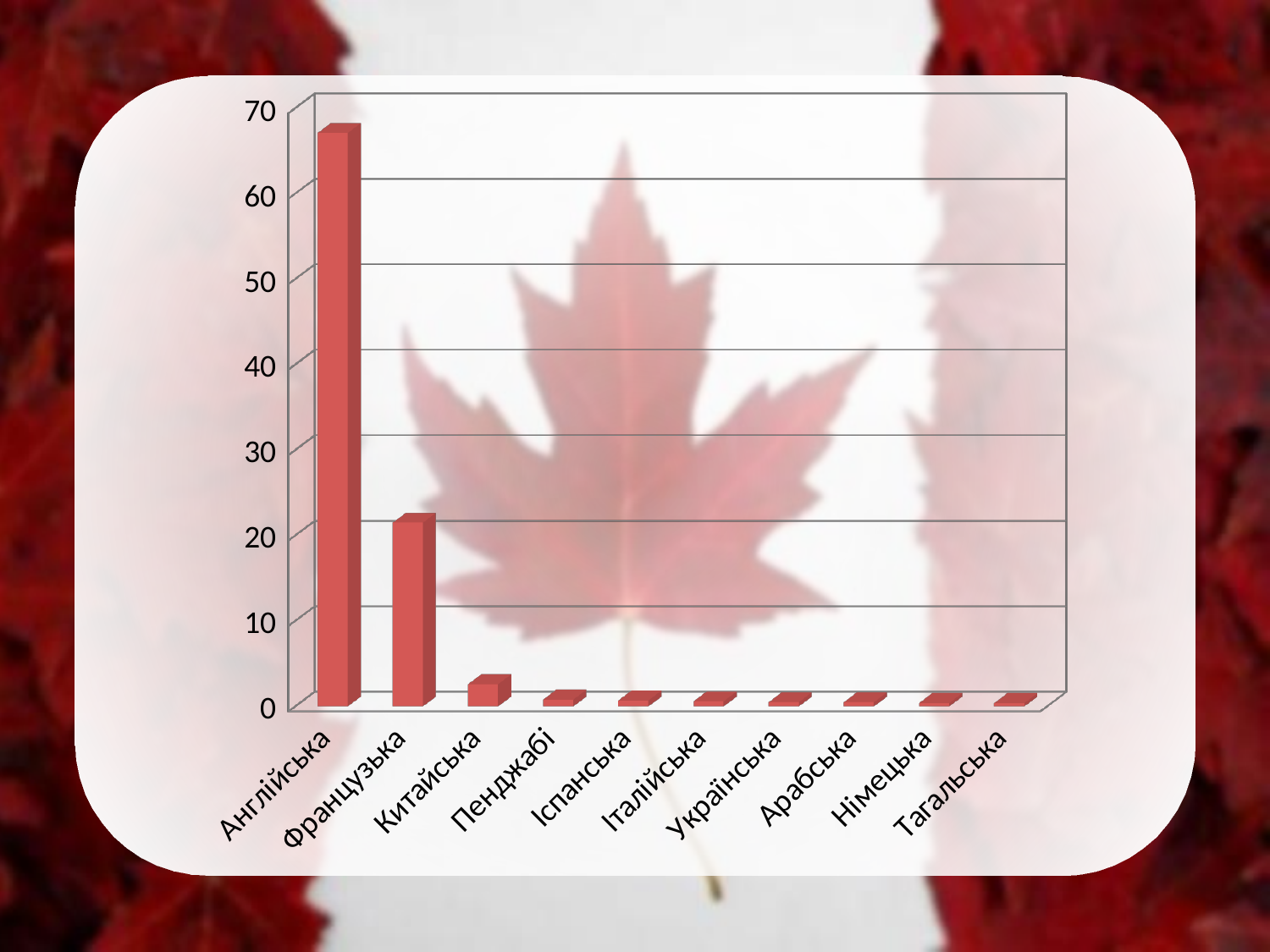
Do the values rise or fall moving from left to right along the x axis? fall What is the highest value shown on the vertical axis? 70 How many language categories are shown on the x axis? 10 Is the value for Французька greater or less than 10? greater Which is larger, the value for Англійська or the value for Французька? Англійська What kind of chart is shown on the slide? bar chart Is the value for Китайська greater or less than 10? less Which language has the highest bar? Англійська Which is larger, the value for Французька or the value for Китайська? Французька What colour are the bars in the chart? red Is the value for Французька greater or less than 30? less